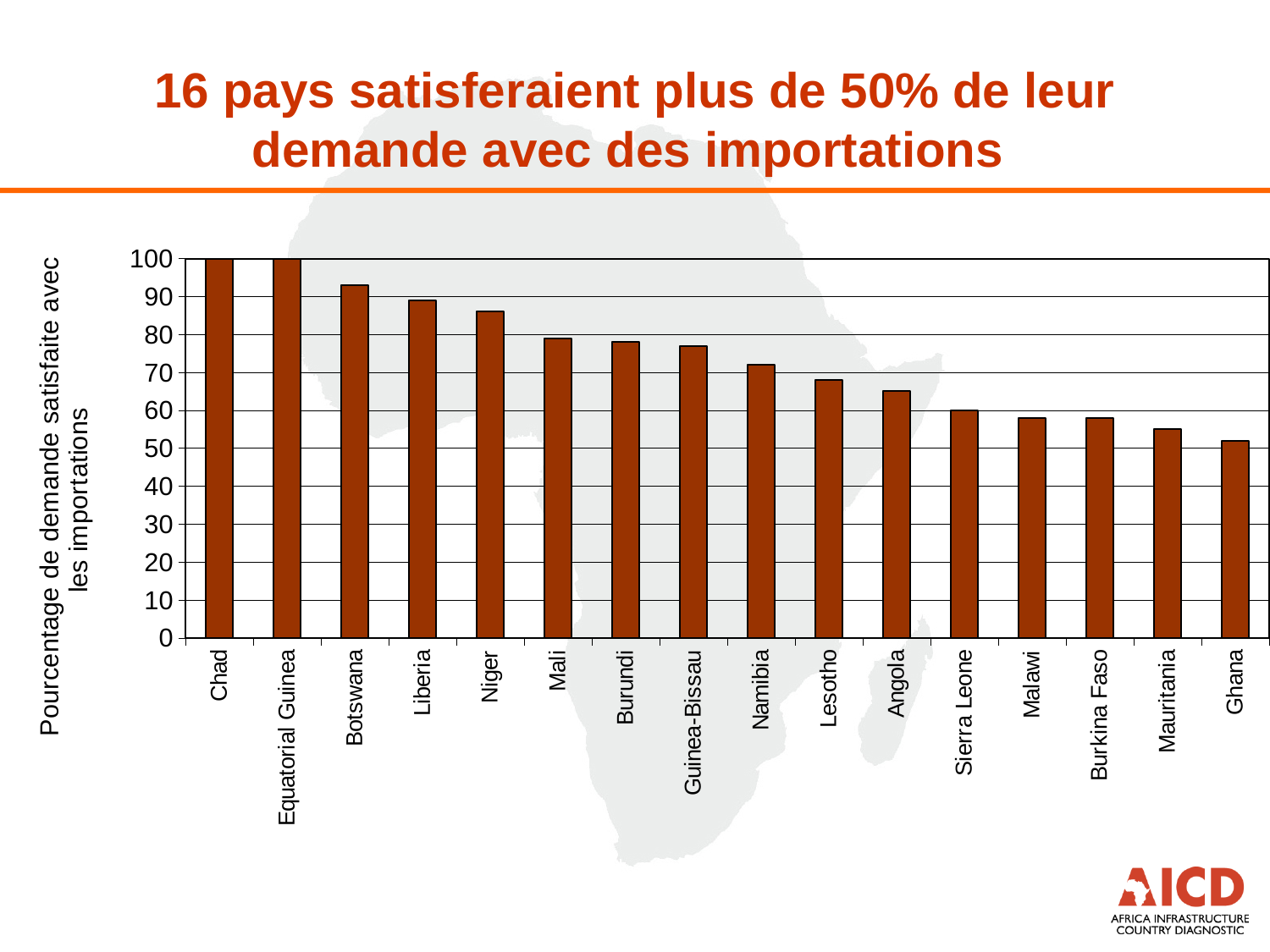
What is the title of the y axis? Pourcentage de demande satisfaite avec les importations Is the value for Namibia greater or less than 70? greater Which country has the lowest value in the chart? Ghana Is the value for Ghana greater or less than 50? greater Is the value for Botswana greater or less than 90? greater Do the values rise or fall from left to right along the x axis? Fall What is the value for Chad? 100 What type of chart is shown on the slide? Bar chart How many countries are shown on the x axis of the chart? 16 What is the value for Sierra Leone? 60 Which has a larger value, Botswana or Niger? Botswana